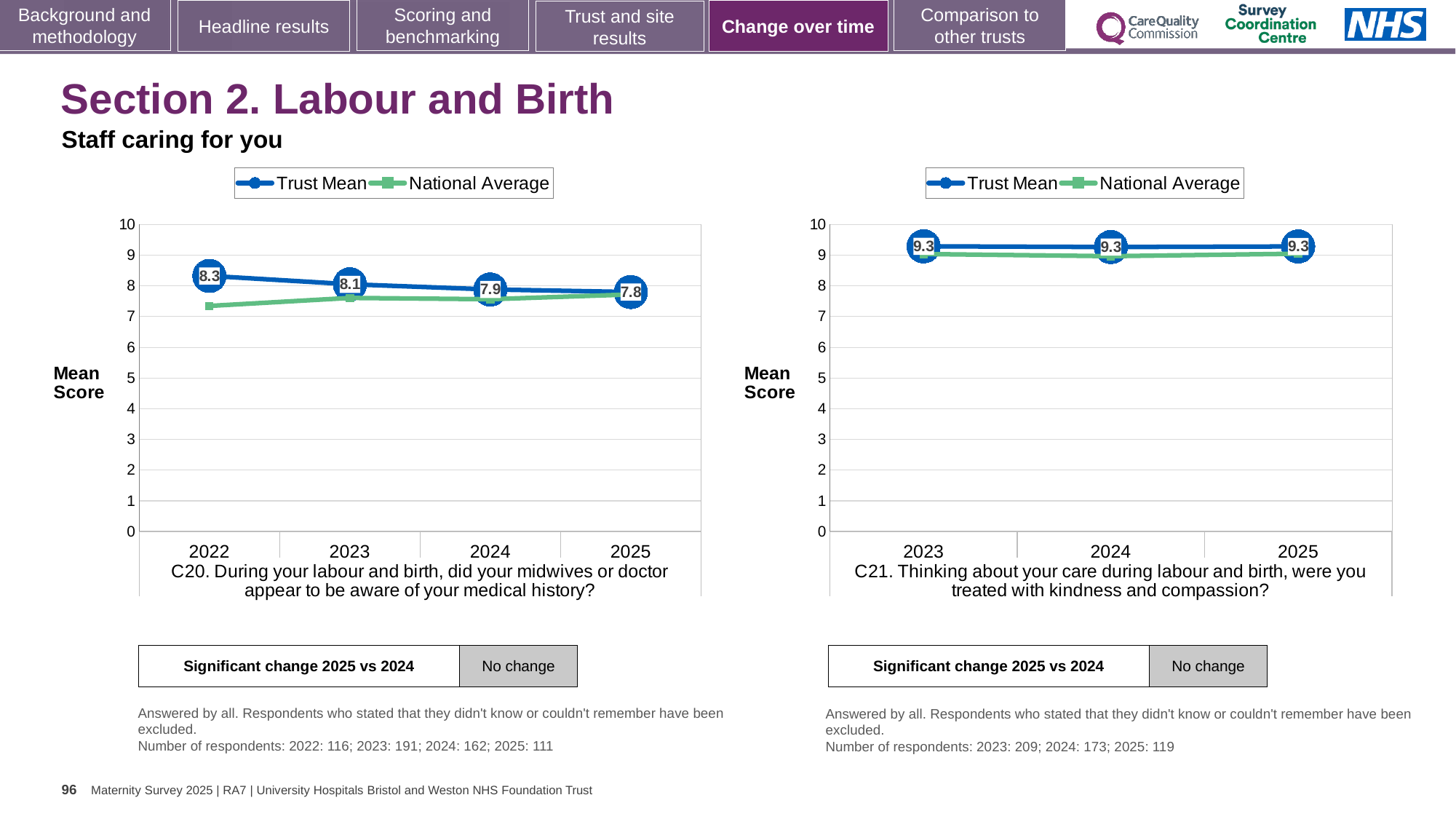
In the C21 chart on the right, what is the Trust Mean for 2024? 9.3 In the C20 chart on the left, what is the Trust Mean for 2022? 8.3 In the C20 chart on the left, which year has the lowest Trust Mean? 2025 How many series does the legend of the C20 chart on the left list? 2 In the C20 chart on the left, is the Trust Mean higher in 2023 or in 2024? 2023 In the C21 chart on the right, is the National Average for 2023 greater or less than 8? greater In the C20 chart on the left, is the National Average for 2022 greater or less than 8? less In the C20 chart on the left, does the Trust Mean rise or fall from 2022 to 2025? fall In the C20 chart on the left, which year has the highest Trust Mean? 2022 In the C20 chart on the left, what is the difference between the Trust Mean in 2022 and in 2025? 0.5 In the C20 chart on the left, what is the Trust Mean for 2025? 7.8 How many years are plotted in the C21 chart on the right? 3